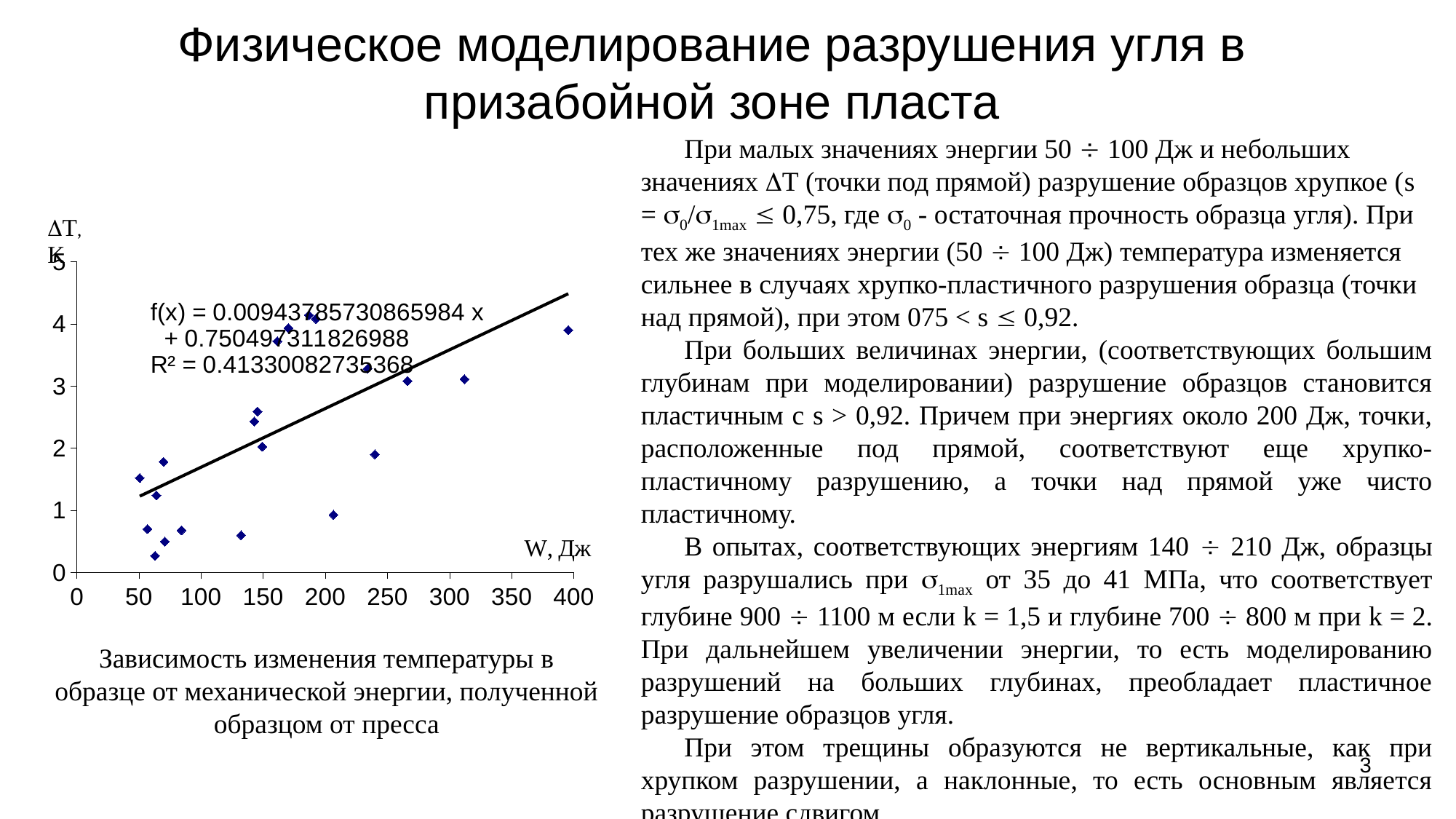
What kind of chart is shown on the slide? scatter chart What is the maximum value shown on the x axis of the chart? 400 What is the intercept (constant term) in the trendline equation printed on the chart? 0.750497311826988 What is the R² value printed on the chart? R² = 0.41330082735368 Is the ΔT value of the point at about W = 400 Дж greater or less than 3? greater Is the ΔT value of the highest point near W = 190 Дж greater or less than 3? greater Is the ΔT value of the point at about W = 205 Дж greater or less than 2? less What is the label of the x axis of the chart? W, Дж What is the slope coefficient of x in the trendline equation printed on the chart? 0.00943785730865984 Does the fitted trendline rise or fall as W increases along the x axis? rises